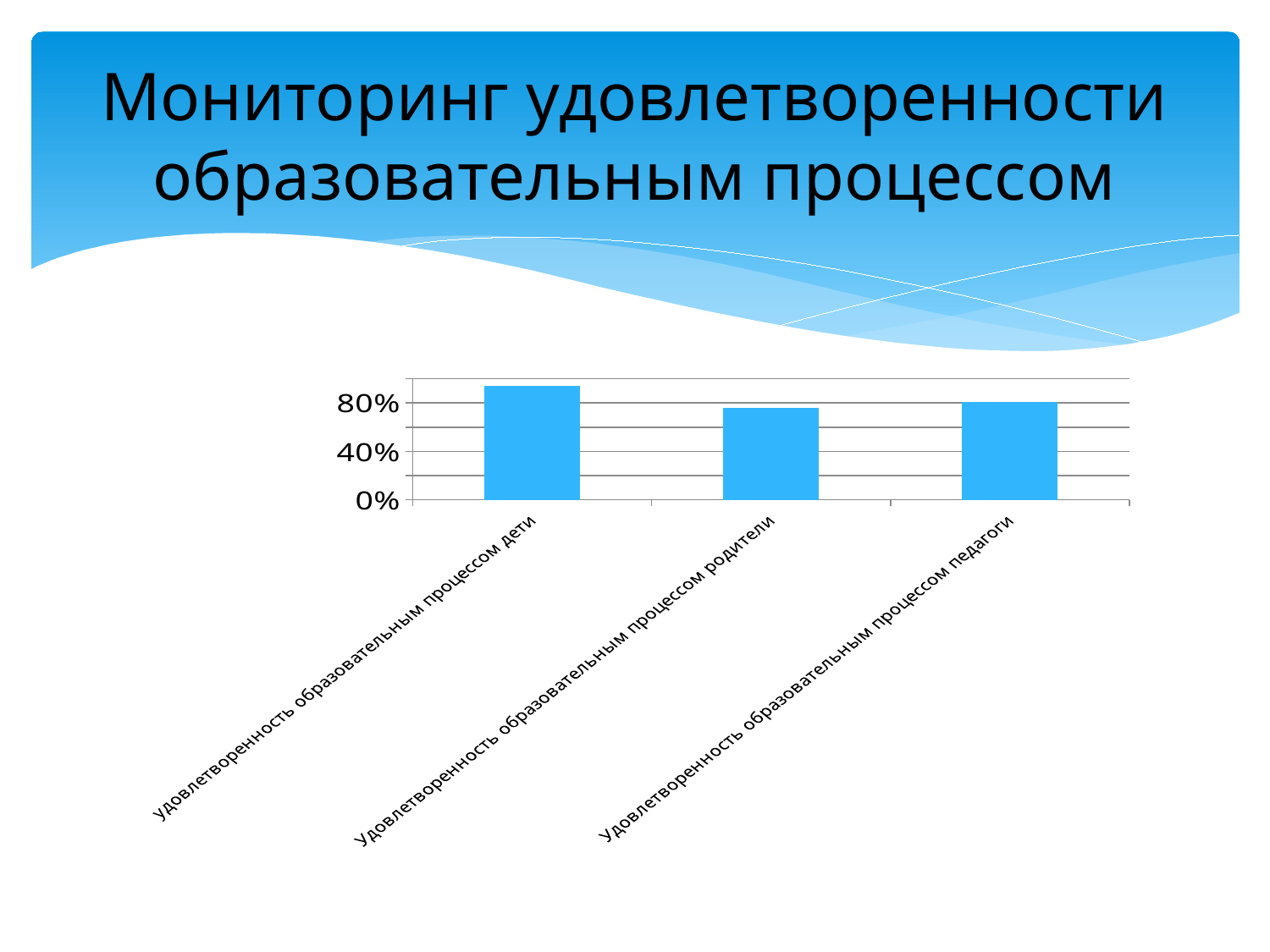
What kind of chart is shown on the slide? bar chart Which is larger: the value for "дети" or the value for "родители"? дети Is the value for "Удовлетворенность образовательным процессом родители" greater or less than 80%? less Which is larger: the value for "дети" or the value for "педагоги"? дети How many categories (bars) does the chart show? 3 What is the title of the slide containing the chart? Мониторинг удовлетворенности образовательным процессом What is the highest tick label shown on the vertical axis? 80% Is the value for "Удовлетворенность образовательным процессом родители" greater or less than 40%? greater Which category has the highest value in the chart? Удовлетворенность образовательным процессом дети Is the value for "Удовлетворенность образовательным процессом педагоги" greater or less than 40%? greater